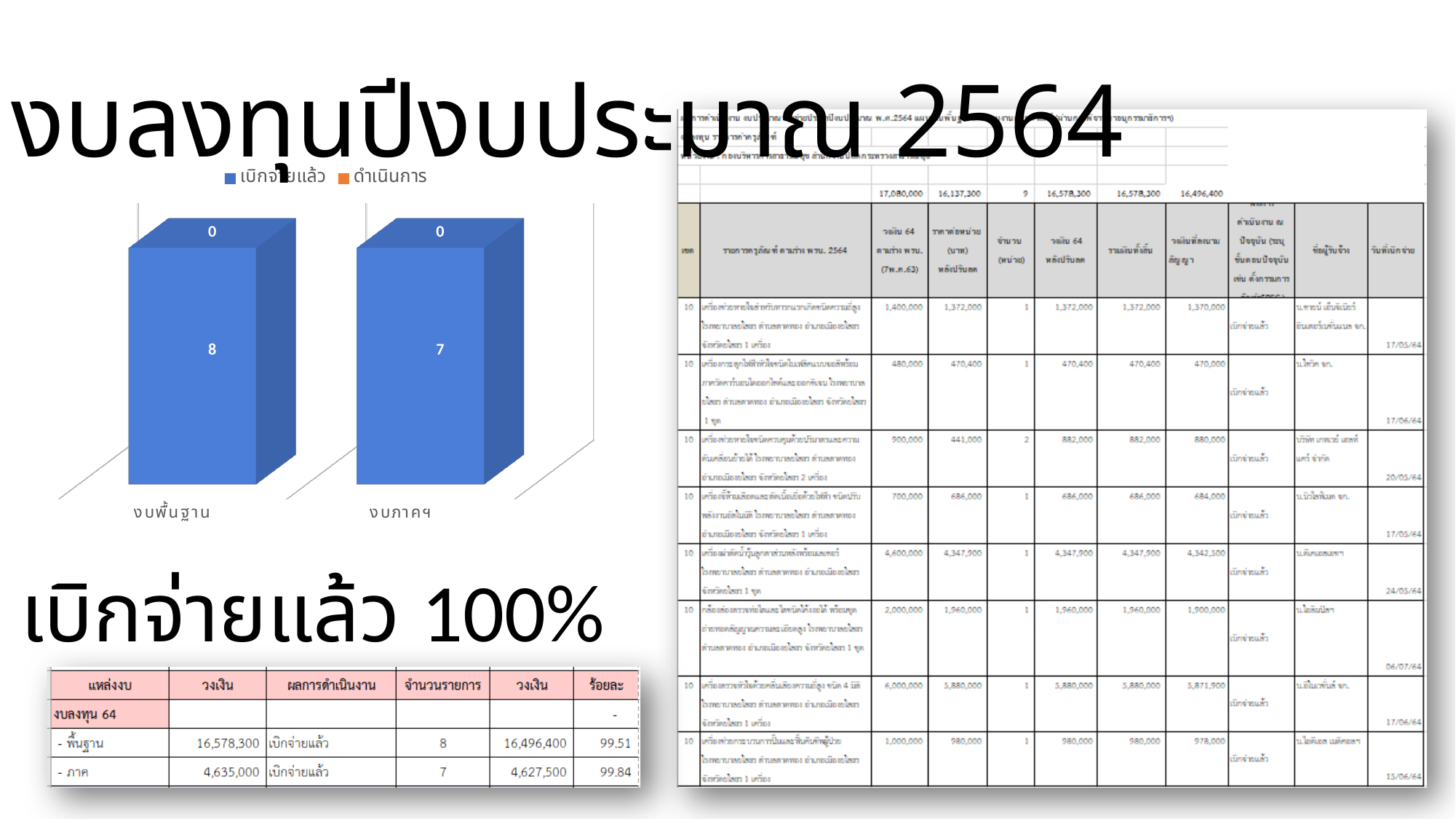
What is the total of the stacked bar for งบภาคฯ? 7 What is the value of ดำเนินการ for งบภาคฯ in the bar chart? 0 How many series does the legend of the bar chart list? 2 What is the value of ดำเนินการ for งบพื้นฐาน in the bar chart? 0 Is the เบิกจ่ายแล้ว value for งบพื้นฐาน larger or smaller than that for งบภาคฯ? larger What kind of chart is shown on the left of the slide? bar chart Which category has the higher เบิกจ่ายแล้ว value in the bar chart? งบพื้นฐาน Which category has the lower เบิกจ่ายแล้ว value in the bar chart? งบภาคฯ What is the value of เบิกจ่ายแล้ว for งบภาคฯ in the bar chart? 7 What is the value of เบิกจ่ายแล้ว for งบพื้นฐาน in the bar chart? 8 How many categories are shown on the x axis of the bar chart? 2 What is the difference between the เบิกจ่ายแล้ว values for งบพื้นฐาน and งบภาคฯ? 1